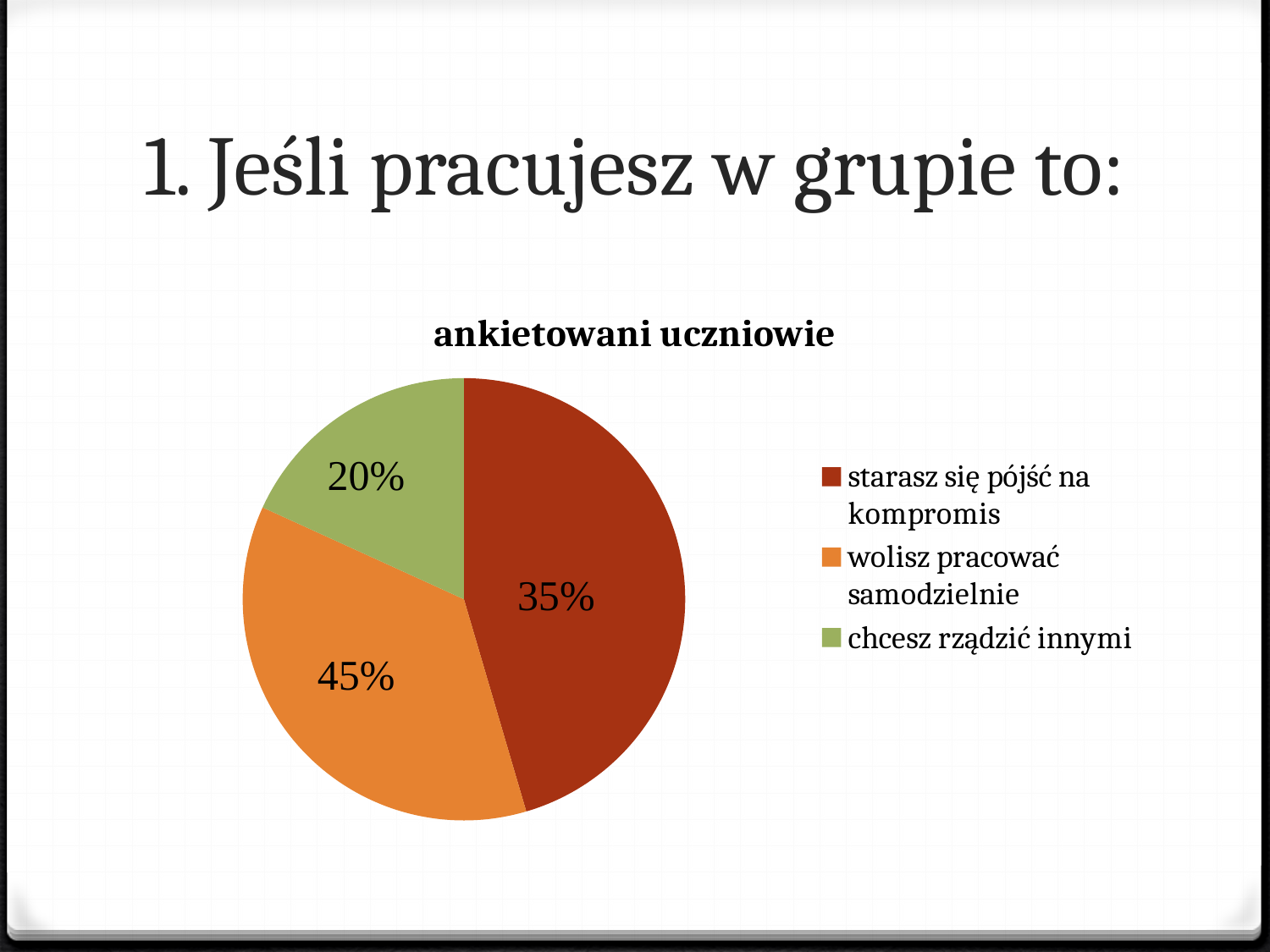
What is the title of the chart? ankietowani uczniowie Which category has the smallest slice of the pie? chcesz rządzić innymi Which is larger: the slice for 'starasz się pójść na kompromis' or the slice for 'chcesz rządzić innymi'? starasz się pójść na kompromis What percentage of the pie is labelled for 'chcesz rządzić innymi'? 20% What kind of chart is shown on the slide? pie chart How many slices does the pie chart have? 3 What colour is the slice for 'chcesz rządzić innymi'? green What percentage of the pie is labelled for 'wolisz pracować samodzielnie'? 45% How many entries does the legend list? 3 Which category has the largest slice of the pie? starasz się pójść na kompromis What is the difference in percentage points between 'wolisz pracować samodzielnie' and 'starasz się pójść na kompromis'? 10 What percentage of the pie is labelled for 'starasz się pójść na kompromis'? 35%